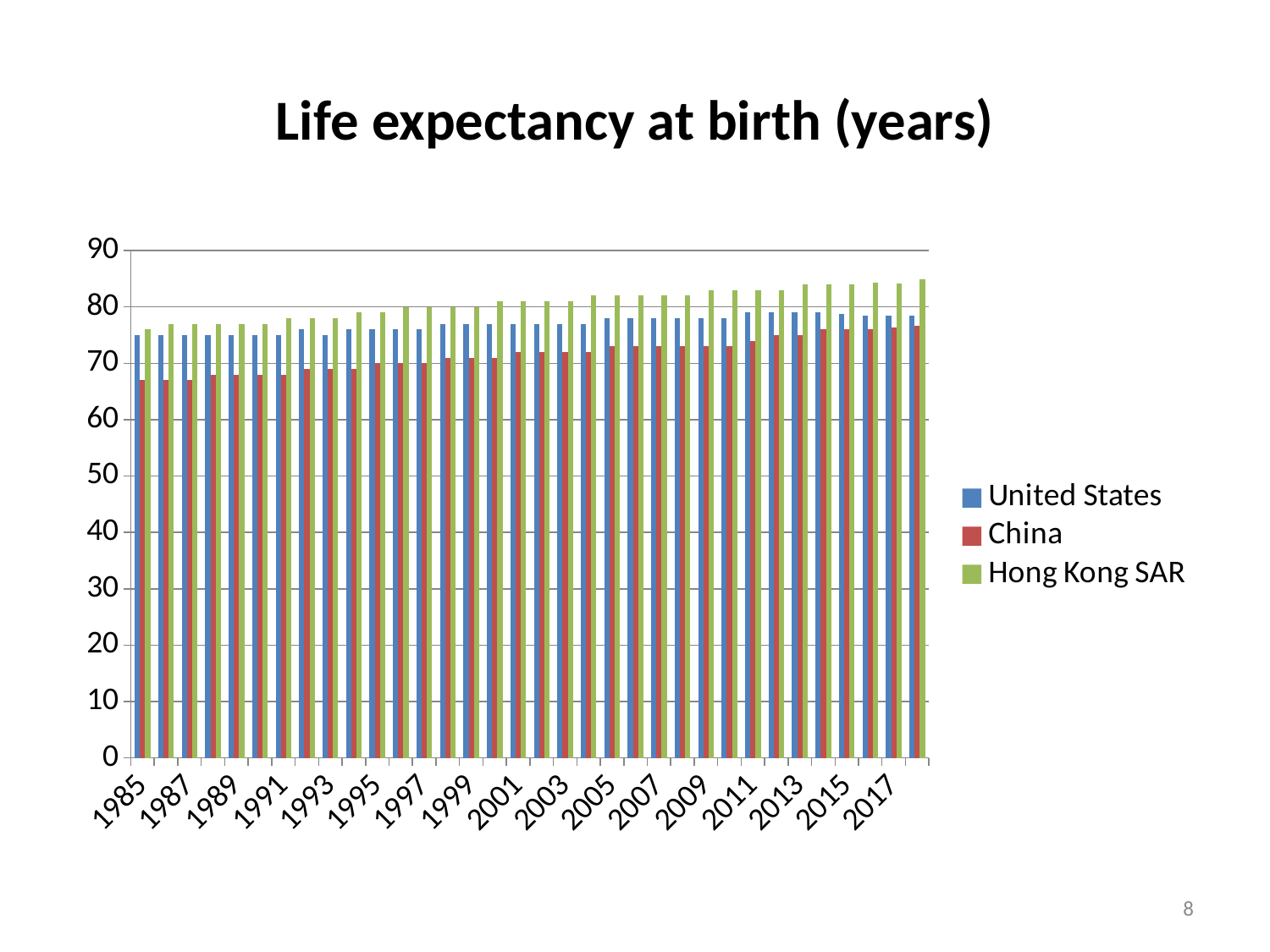
What kind of chart is shown on the slide? bar chart Is the value for Hong Kong SAR in 1985 greater or less than 70? greater Do the values for China rise or fall from 1985 to 2017? rise Which series is shown in green in the legend? Hong Kong SAR Is the value for China in 2017 greater or less than 70? greater What is the title of the chart? Life expectancy at birth (years) In 2017, which is larger: the value for Hong Kong SAR or the value for United States? Hong Kong SAR In 1985, which is larger: the value for United States or the value for China? United States Is the value for United States in 1985 greater or less than 80? less How many series does the legend list? 3